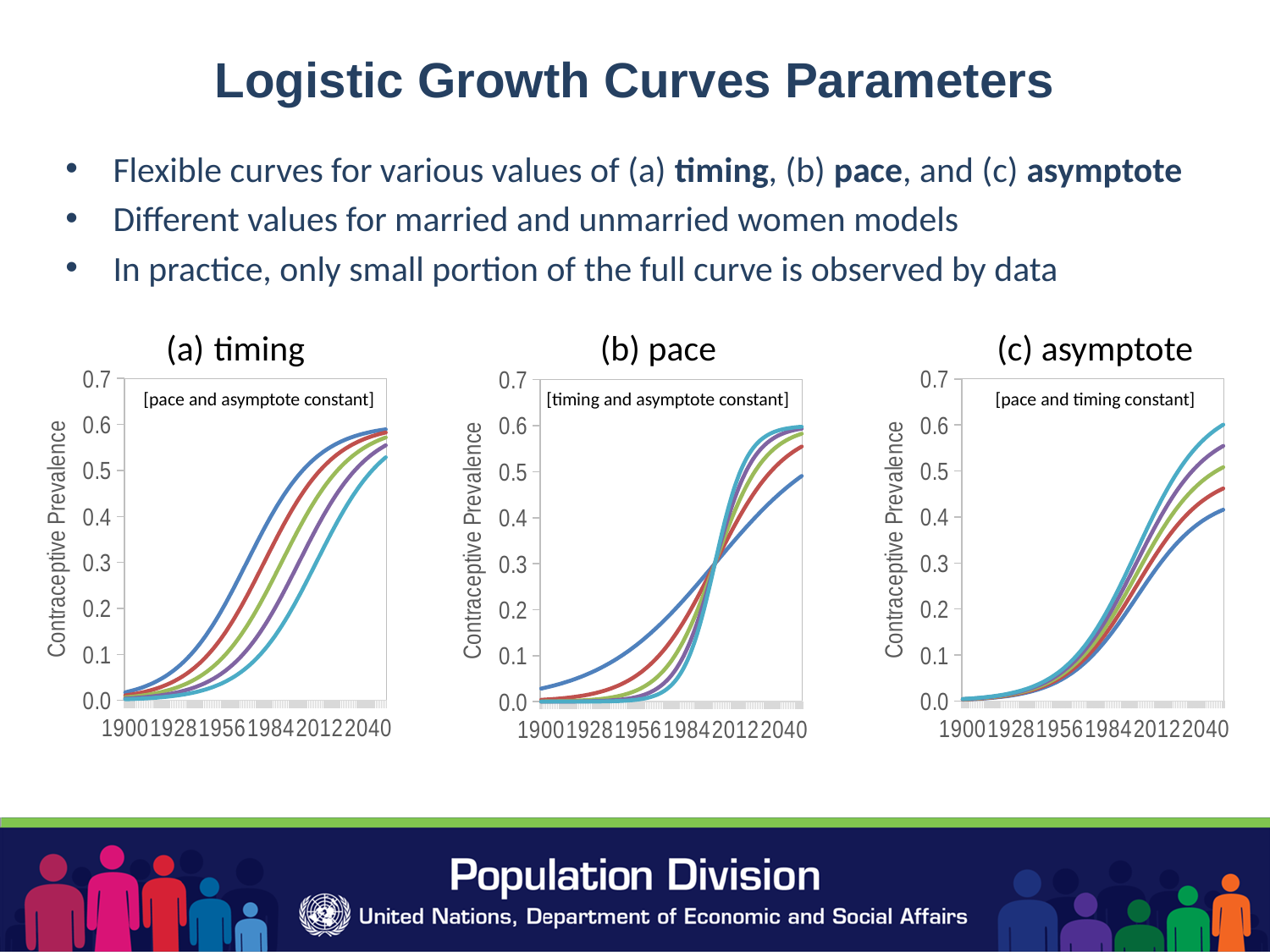
On the '(a) timing' chart, do the curves rise or fall as the year increases along the x axis? rise On the '(a) timing' chart, at 1984 which curve has the higher value, the dark blue curve or the light blue curve? dark blue On the '(c) asymptote' chart, is the value of the light blue (highest) curve at 2040 greater or less than 0.5? greater What kind of chart is the '(a) timing' chart? line chart What is the y-axis label on the '(b) pace' chart? Contraceptive Prevalence What text appears in the box inside the '(c) asymptote' chart? [pace and timing constant] On the '(c) asymptote' chart, at 2040 which curve has the higher value, the light blue curve or the red curve? light blue On the '(b) pace' chart, is the value of the dark blue (flattest) curve at 1900 greater or less than 0.1? less How many curves are plotted on the '(c) asymptote' chart? 5 On the '(c) asymptote' chart, is the value of the dark blue (lowest) curve at 2040 greater or less than 0.5? less How many curves are plotted on the '(b) pace' chart? 5